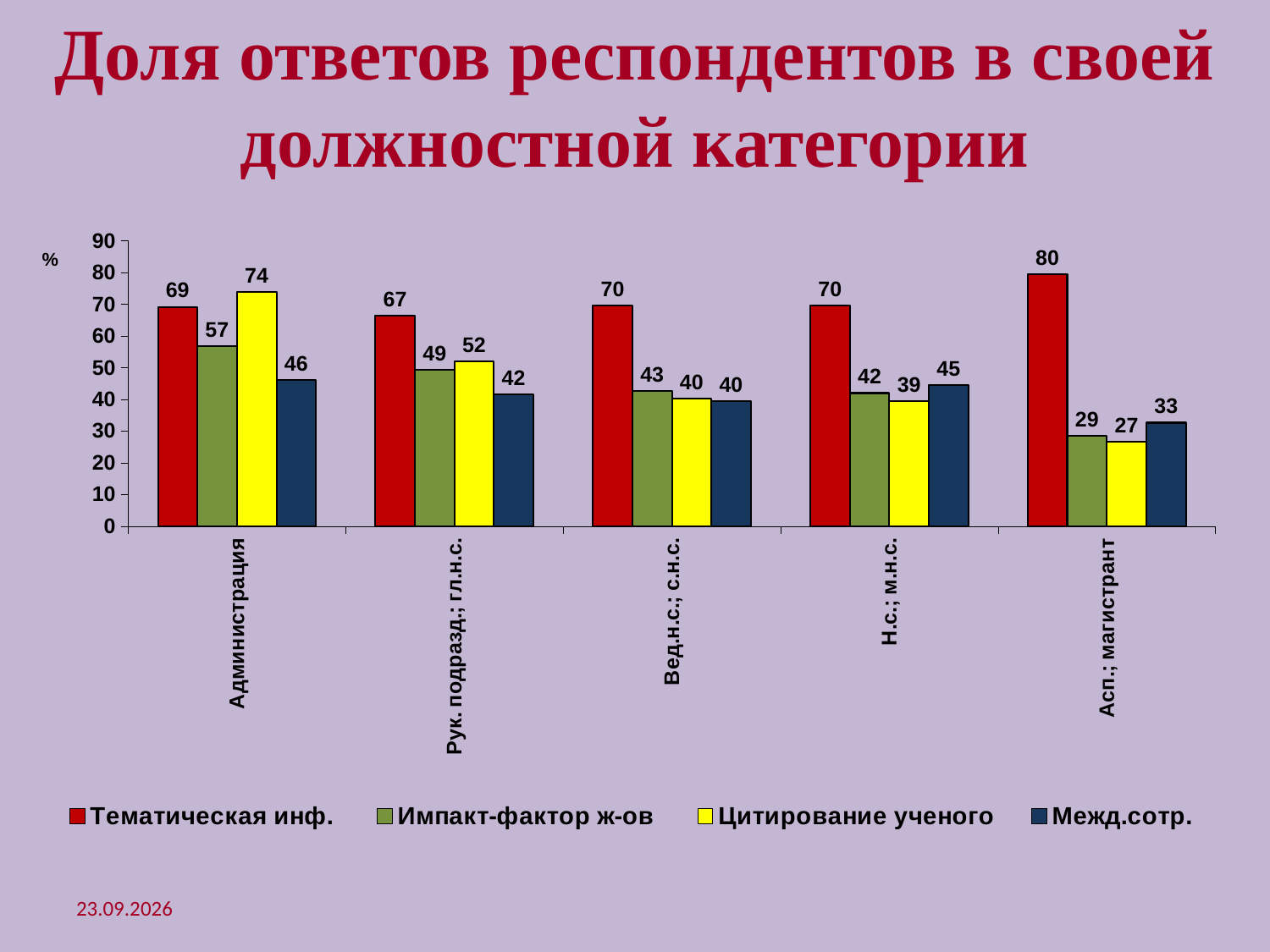
How many series does the legend list? 4 What is the difference between Цитирование ученого and Импакт-фактор ж-ов in the Администрация category? 17 How many categories are shown on the x axis? 5 Does the value for Импакт-фактор ж-ов rise or fall from Администрация to Асп.; магистрант? fall In the Рук. подразд.; гл.н.с. category, which is larger: Импакт-фактор ж-ов or Цитирование ученого? Цитирование ученого What is the value for Тематическая инф. in the Администрация category? 69 What kind of chart is shown on the slide? bar chart Which category has the lowest value for Импакт-фактор ж-ов? Асп.; магистрант What colour are the bars for Цитирование ученого? yellow What is the value for Межд.сотр. in the Н.с.; м.н.с. category? 45 What is the value for Цитирование ученого in the Асп.; магистрант category? 27 Which category has the highest value for Тематическая инф.? Асп.; магистрант